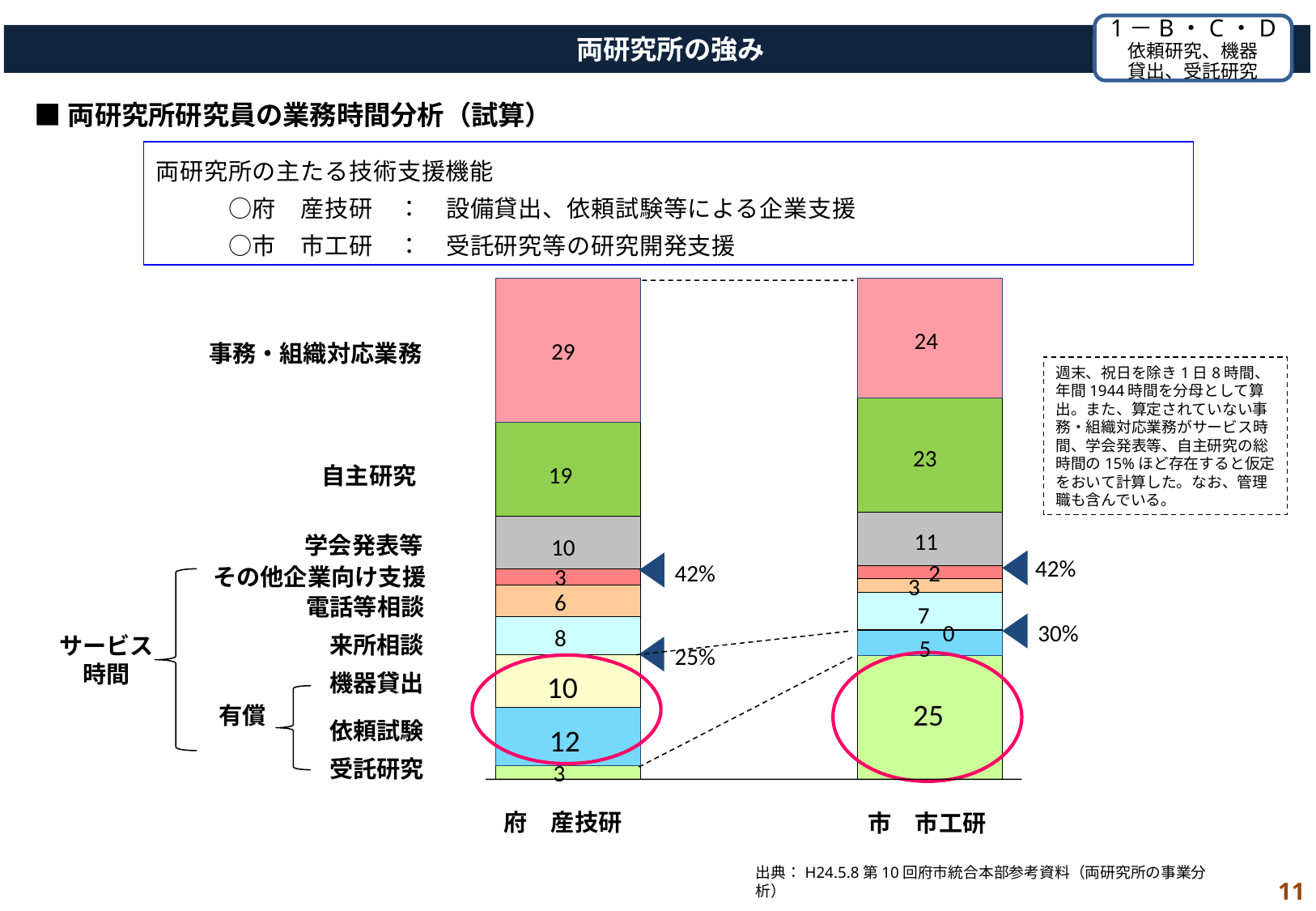
How many bars (institutions) are plotted in the chart? 2 What is the value of 依頼試験 for 府 産技研? 12 Which institution has the larger value for 受託研究, 府 産技研 or 市 市工研? 市 市工研 What is the value of 学会発表等 for 市 市工研? 11 What is the value of 事務・組織対応業務 for 府 産技研? 29 What kind of chart is shown on the slide? stacked bar chart Which segment is the largest in the 府 産技研 bar? 事務・組織対応業務 What is the value of 自主研究 for 市 市工研? 23 What is the total of all segments in the 府 産技研 bar? 100 What is the value of 受託研究 for 市 市工研? 25 What percentage is marked next to the 市 市工研 bar for the 有償 (paid) services? 30% What is the difference between the 事務・組織対応業務 values of 府 産技研 (29) and 市 市工研 (24)? 5